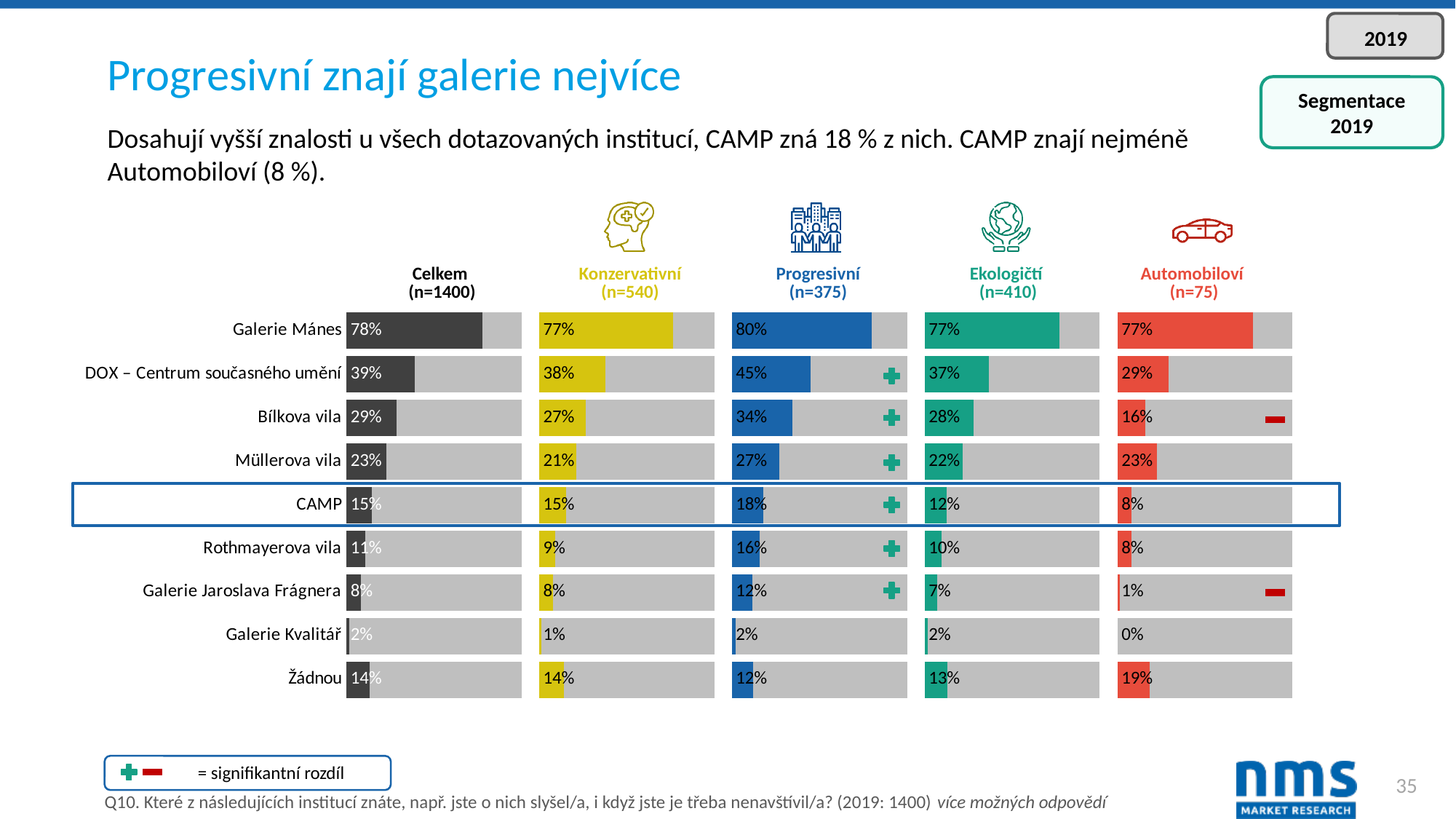
What kind of chart is used to show the values for each segment on this slide? Bar chart Which category row is highlighted with a blue outline across all the charts? CAMP In the Celkem (n=1400) chart, what is the value for DOX – Centrum současného umění? 39% In the Ekologičtí (n=410) chart, which category has the highest value? Galerie Mánes In the Konzervativní (n=540) chart, which category has the lowest value? Galerie Kvalitář In the Automobiloví (n=75) chart, what is the value for Bílkova vila? 16% In the Konzervativní (n=540) chart, what is the value for Žádnou? 14% In the Ekologičtí (n=410) chart, what is the difference between the values for CAMP and Rothmayerova vila? 2% In the Automobiloví (n=75) chart, which is larger: the value for Müllerova vila or the value for Bílkova vila? Müllerova vila In the Progresivní (n=375) chart, what is the value for CAMP? 18% How many categories are shown in the Celkem (n=1400) chart? 9 In the Progresivní (n=375) chart, what is the difference between the values for Galerie Mánes and DOX – Centrum současného umění? 35%